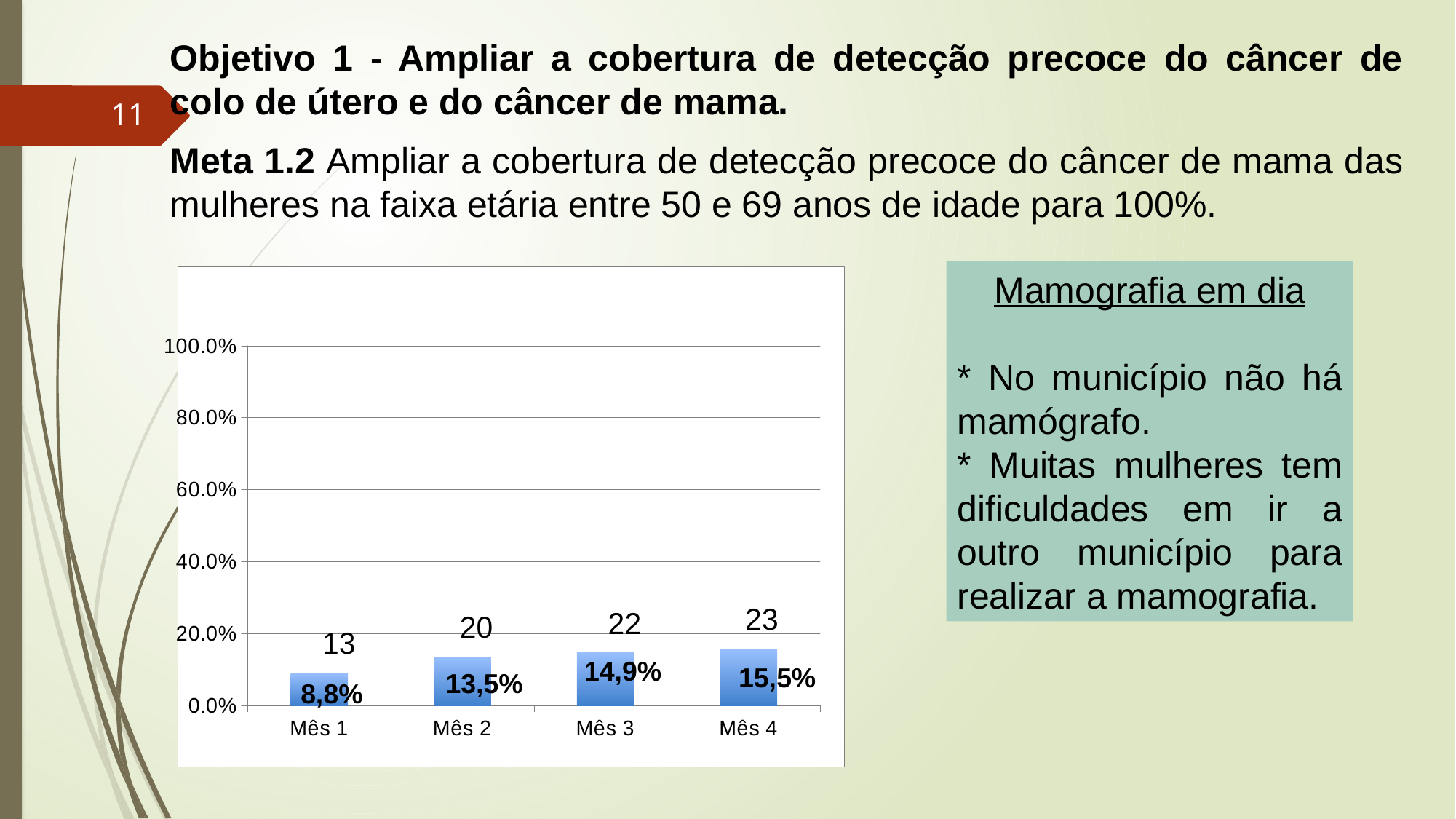
What number is printed above the bar for Mês 2? 20 Which is larger, the percentage for Mês 2 or for Mês 3? Mês 3 What kind of chart is shown on the slide? bar chart Is the value for Mês 4 greater or less than 20.0%? less Do the percentages rise or fall from Mês 1 to Mês 4? rise How many months are shown on the x axis? 4 What is the difference between the numbers printed above the bars for Mês 4 and Mês 1? 10 What percentage is shown for Mês 1? 8,8% Which month has the lowest percentage? Mês 1 What number is printed above the bar for Mês 4? 23 What percentage is shown for Mês 3? 14,9% Which month has the highest percentage? Mês 4